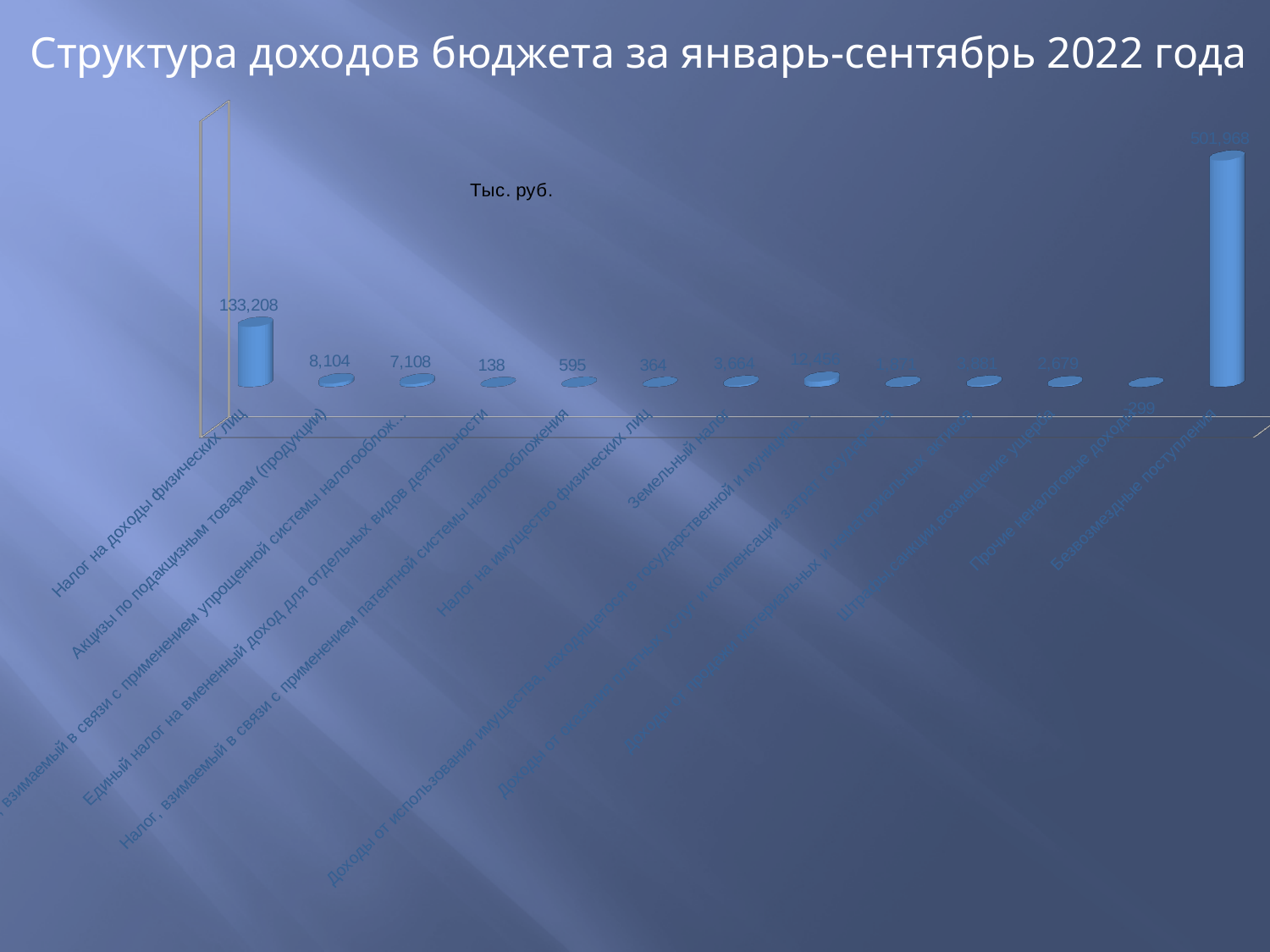
How many categories are plotted in the chart? 13 What is the value for Налог на доходы физических лиц? 133,208 What is the value for Акцизы по подакцизным товарам (продукции)? 8,104 What is the value for Единый налог на вмененный доход для отдельных видов деятельности? 138 Which category has the highest value? Безвозмездные поступления What unit is indicated on the chart? Тыс. руб. What is the value for Налог на имущество физических лиц? 364 What is the value for Налог, взимаемый в связи с применением патентной системы налогообложения? 595 What is the value for Земельный налог? 3,664 What is the difference between the values for Налог на доходы физических лиц and Акцизы по подакцизным товарам (продукции)? 125,104 Which is larger: Земельный налог or Налог на имущество физических лиц? Земельный налог What kind of chart is shown on the slide? Bar chart